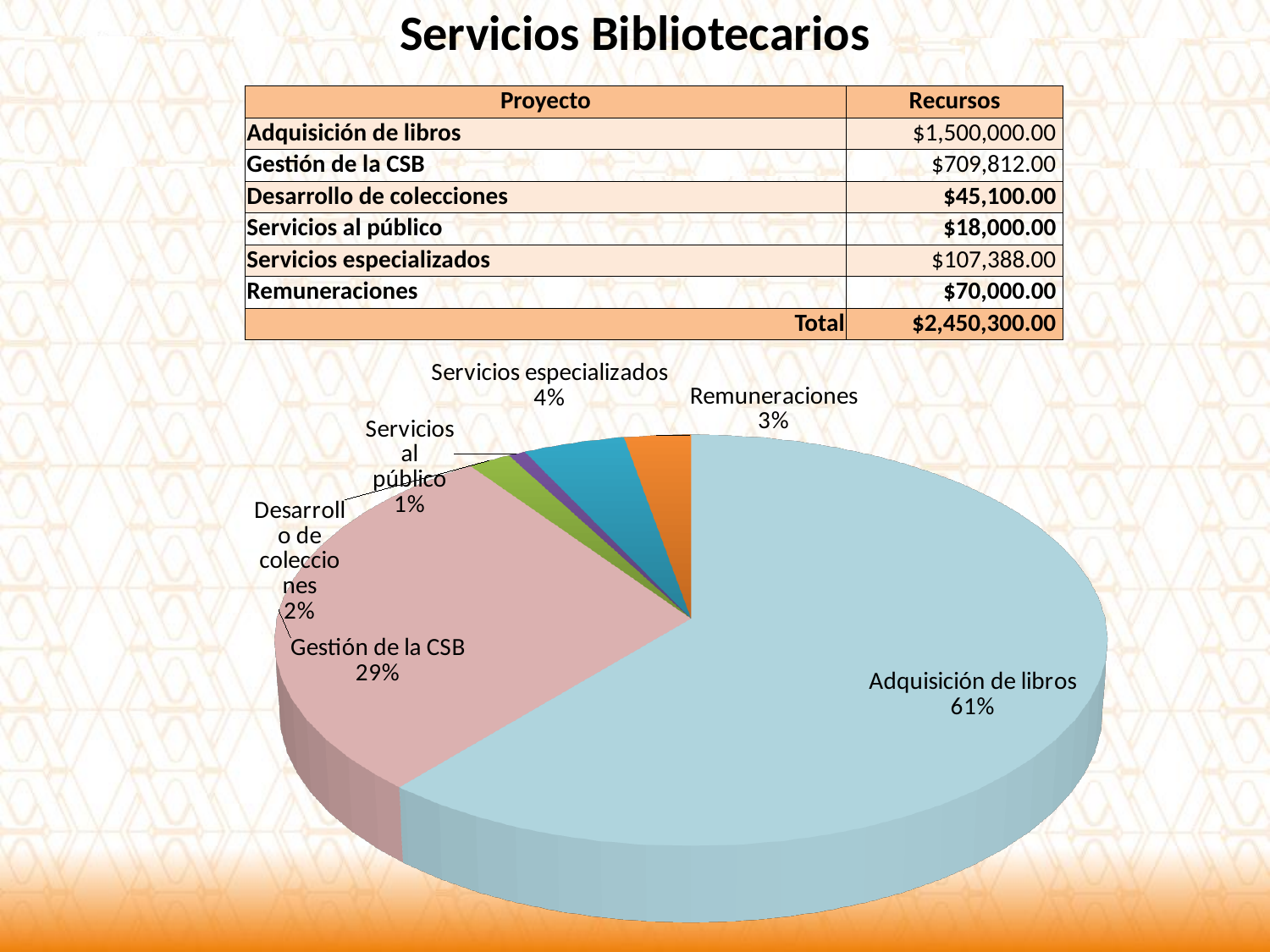
What share of the pie does Gestión de la CSB represent? 29% What percentage is shown for Servicios al público in the pie chart? 1% What percentage is shown for Servicios especializados in the pie chart? 4% What kind of chart is shown on the slide? Pie chart What percentage is shown for Remuneraciones in the pie chart? 3% Which slice is larger, Gestión de la CSB or Servicios especializados? Gestión de la CSB What is the title of the slide containing the chart? Servicios Bibliotecarios How many slices does the pie chart have? 6 What share of the pie does Adquisición de libros represent? 61% What is the difference in percentage points between Adquisición de libros and Gestión de la CSB? 32 Which category has the smallest slice of the pie? Servicios al público Which category has the largest slice of the pie? Adquisición de libros